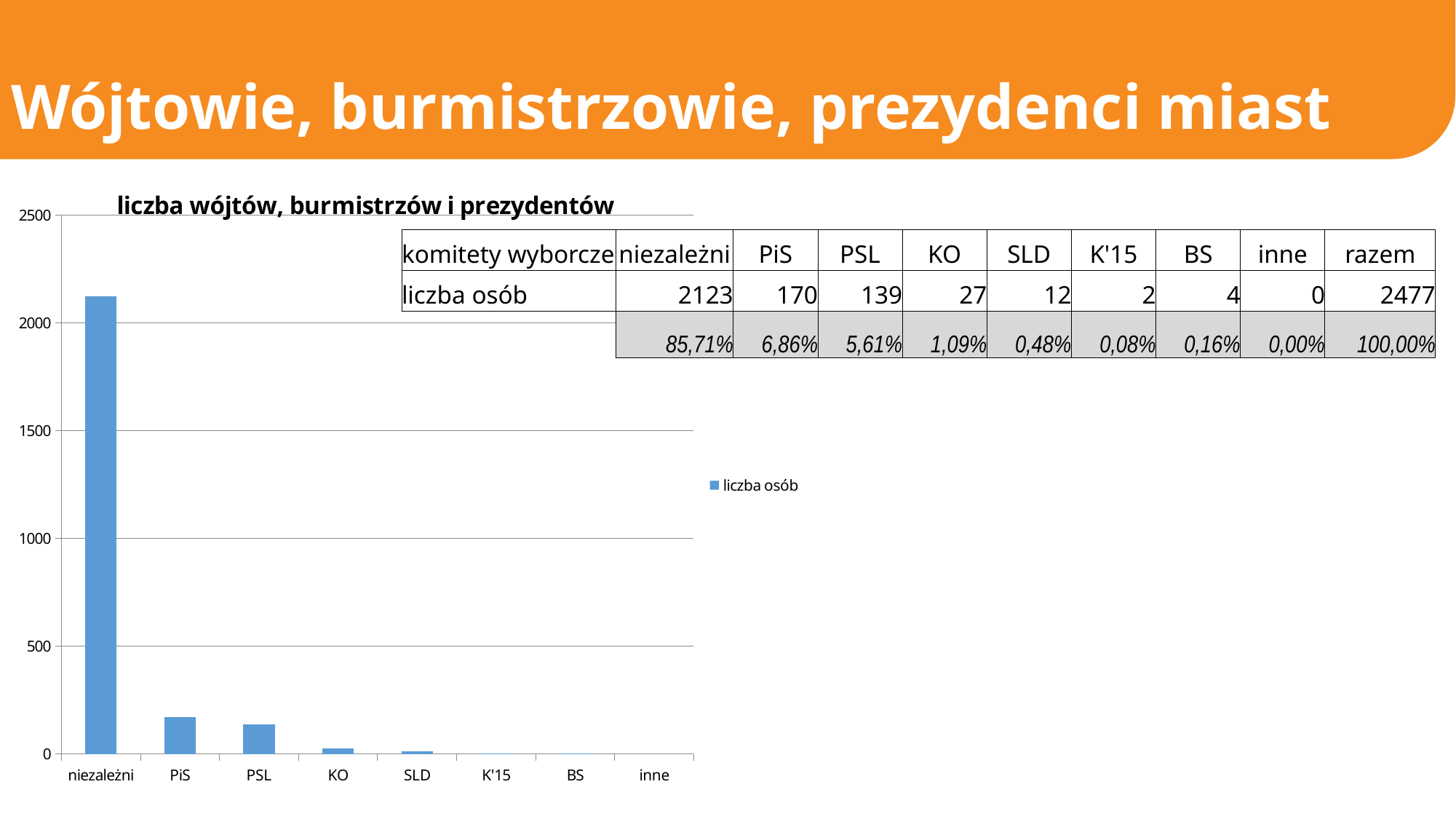
Which is larger in the chart, the value for PiS or the value for PSL? PiS According to the table on the slide, what is the number of people (liczba osób) for PiS? 170 According to the table on the slide, what is the number of people (liczba osób) for niezależni? 2123 Is the value for niezależni in the chart greater or less than 2000? greater Which category has the highest bar in the chart? niezależni What type of chart is shown on the slide? bar chart Using the values in the table, what is the difference between the number of people for PiS and for PSL? 31 What is the title of the chart? liczba wójtów, burmistrzów i prezydentów According to the table on the slide, what is the total (razem) number of people? 2477 Is the value for PiS in the chart greater or less than 500? less How many series does the chart legend list? 1 How many categories are shown on the x axis of the chart? 8